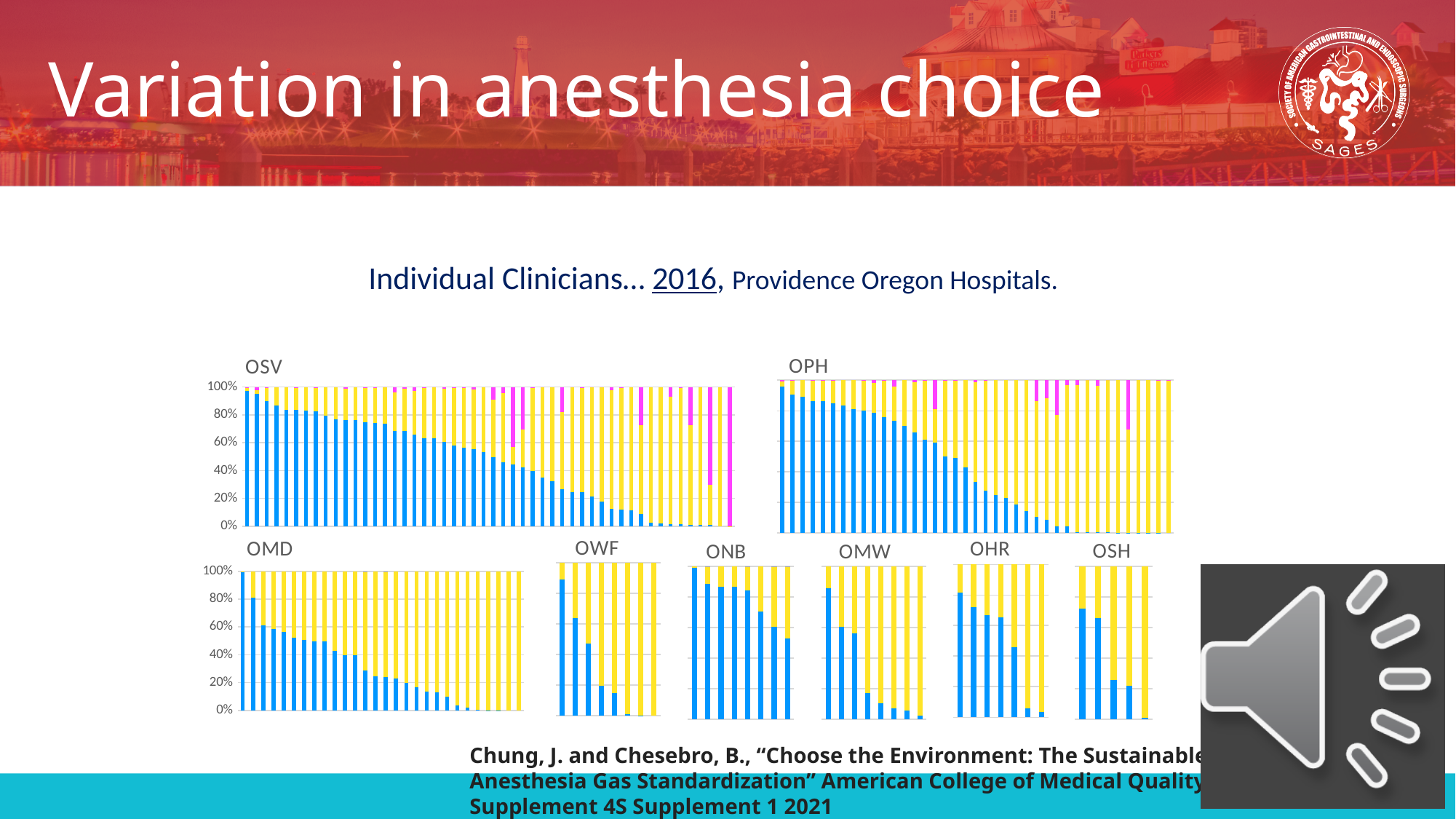
How many charts are in the bottom row of the slide? 6 What kind of chart is used for the OSV panel? bar chart In the OSV chart, does the blue portion of the bars rise or fall from left to right? fall In the OSH chart, is the blue portion of the first (leftmost) bar greater or less than 60%? greater How many separate charts are shown on the slide? 8 Which chart on the slide has the fewest bars? OSH In the OPH chart, does the blue portion of the bars rise or fall from left to right? fall What are the titles of the two charts in the top row? OSV and OPH In the OMD chart, is the blue portion of the first (leftmost) bar greater or less than 80%? greater In the ONB chart, is the blue portion of the last (rightmost) bar greater or less than 60%? less What is the highest value shown on the vertical axis of the OMD chart? 100%